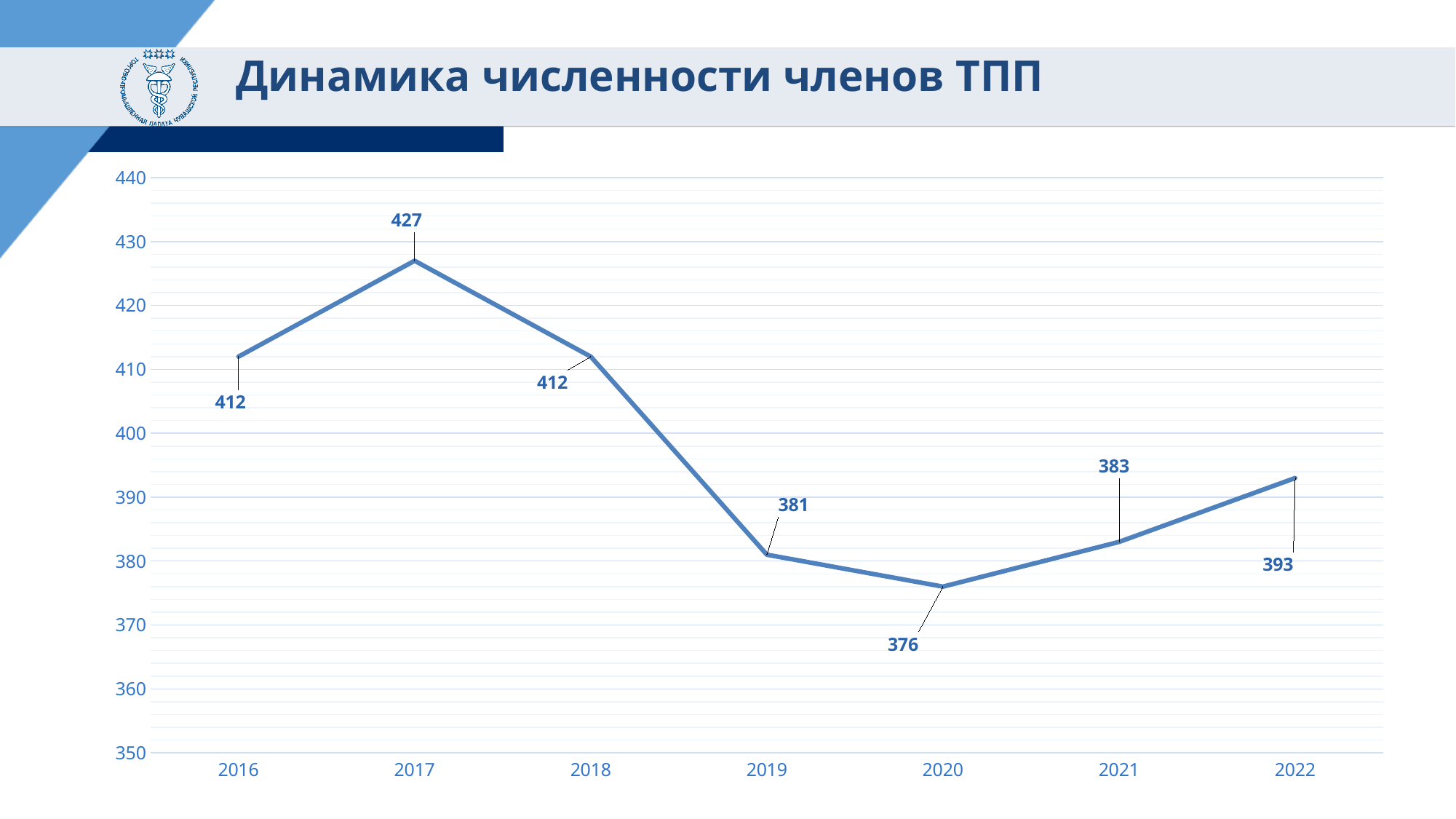
How many years are plotted on the chart? 7 What was the number of members in 2020? 376 Which is larger, the value for 2019 or the value for 2021? 2021 Is the value for 2018 greater or less than 400? greater Which year had the highest number of members? 2017 What was the number of members in 2017? 427 Do the values rise or fall from 2017 to 2020? fall What is the difference between the values for 2022 and 2021? 10 What kind of chart is shown on the slide? line chart What was the number of members in 2022? 393 What is the difference between the values for 2017 and 2020? 51 Which year had the lowest number of members? 2020